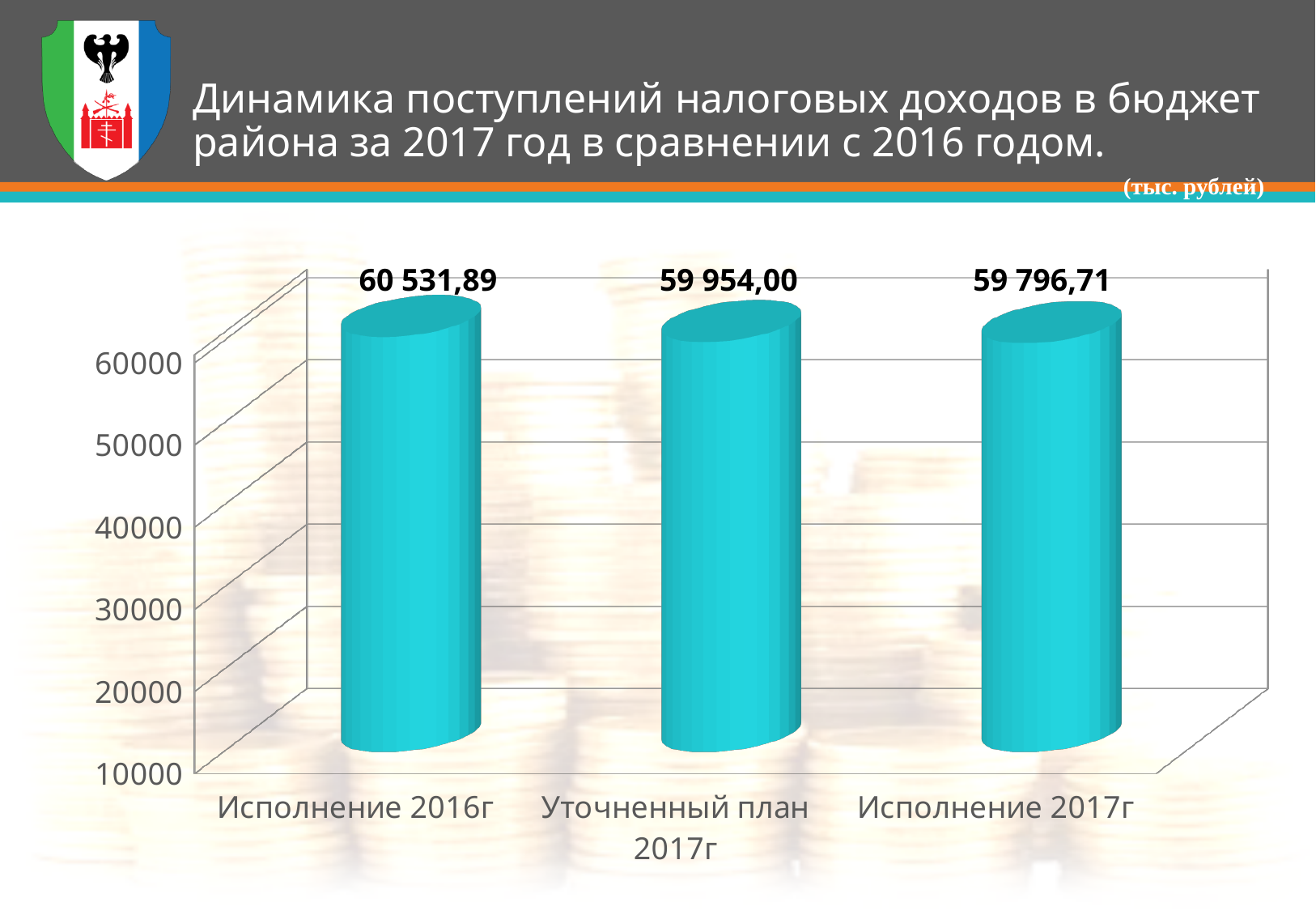
What is the value for Исполнение 2016г? 60 531,89 How many categories are shown in the chart? 3 What is the difference between Уточненный план 2017г and Исполнение 2017г? 157,29 What kind of chart is shown on the slide? bar chart What is the value for Исполнение 2017г? 59 796,71 Is the value for Исполнение 2017г greater or less than 50000? greater What is the value for Уточненный план 2017г? 59 954,00 Do the values rise or fall from left to right along the x axis? fall Which category has the highest value? Исполнение 2016г What is the difference between Исполнение 2016г and Исполнение 2017г? 735,18 Which is larger, Исполнение 2016г or Уточненный план 2017г? Исполнение 2016г Which category has the lowest value? Исполнение 2017г